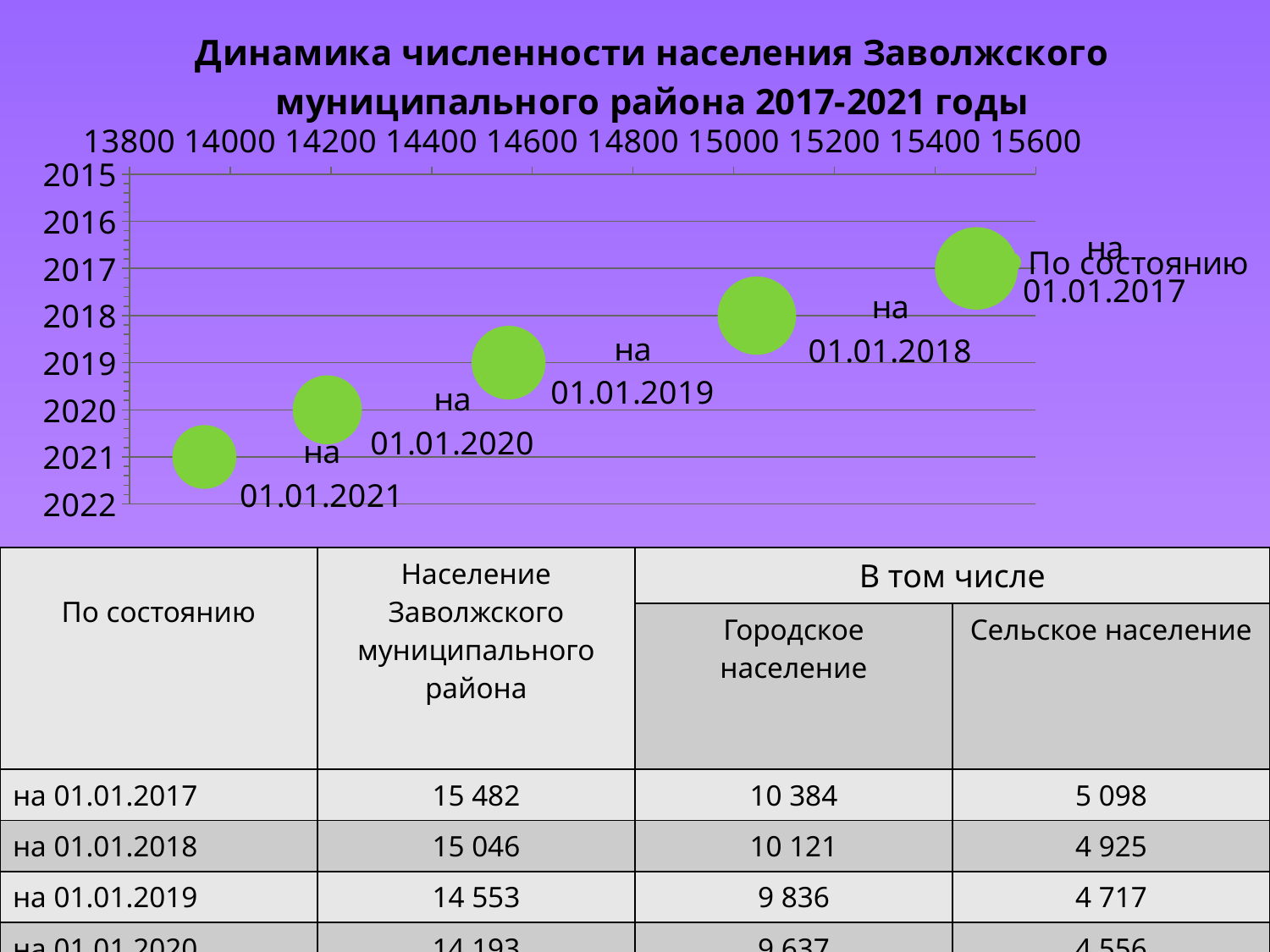
Which is larger, the value for на 01.01.2019 or the value for на 01.01.2020? на 01.01.2019 Is the value for на 01.01.2020 greater or less than 14400? less What kind of chart is shown on the slide? bubble chart Is the value for на 01.01.2018 greater or less than 15200? less Which date has the lowest population value on the chart? на 01.01.2021 What is the population of the Zavolzhsky municipal district on 01.01.2017 according to the slide? 15 482 Is the value for на 01.01.2021 greater or less than 14200? less What is the title of the chart? Динамика численности населения Заволжского муниципального района 2017-2021 годы Which date has the highest population value on the chart? на 01.01.2017 How many data points (bubbles) are plotted on the chart? 5 Does the population rise or fall from 01.01.2017 to 01.01.2021? fall